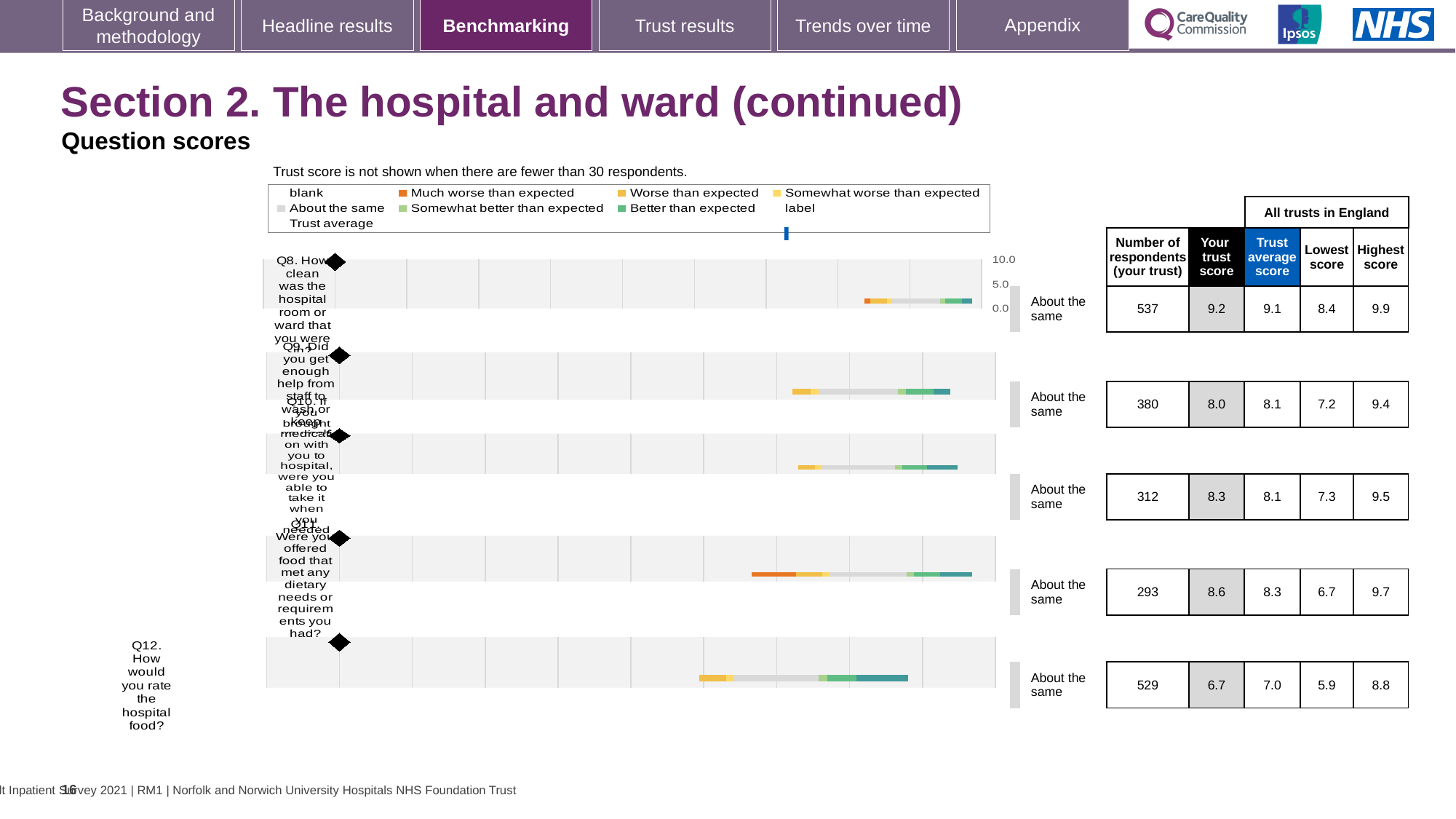
For Q9, which is larger: the trust score or the trust average score? Trust average score Which question has the most respondents at this trust? Q8 How many questions are plotted in the chart? 5 What is the trust score for Q8 (how clean was the hospital room or ward)? 9.2 For Q10, which is larger: the trust score or the trust average score? Trust score What is the trust average score for Q11 (offered food that met dietary needs)? 8.3 How many respondents answered Q12 (how would you rate the hospital food) at this trust? 529 What kind of chart is used to show the question scores? Bar chart What benchmark category is shown for Q12? About the same What is the difference between the highest score and the lowest score for Q11? 3.0 Which question has the highest 'Your trust score' on this slide? Q8 Which question has the lowest 'Your trust score' on this slide? Q12